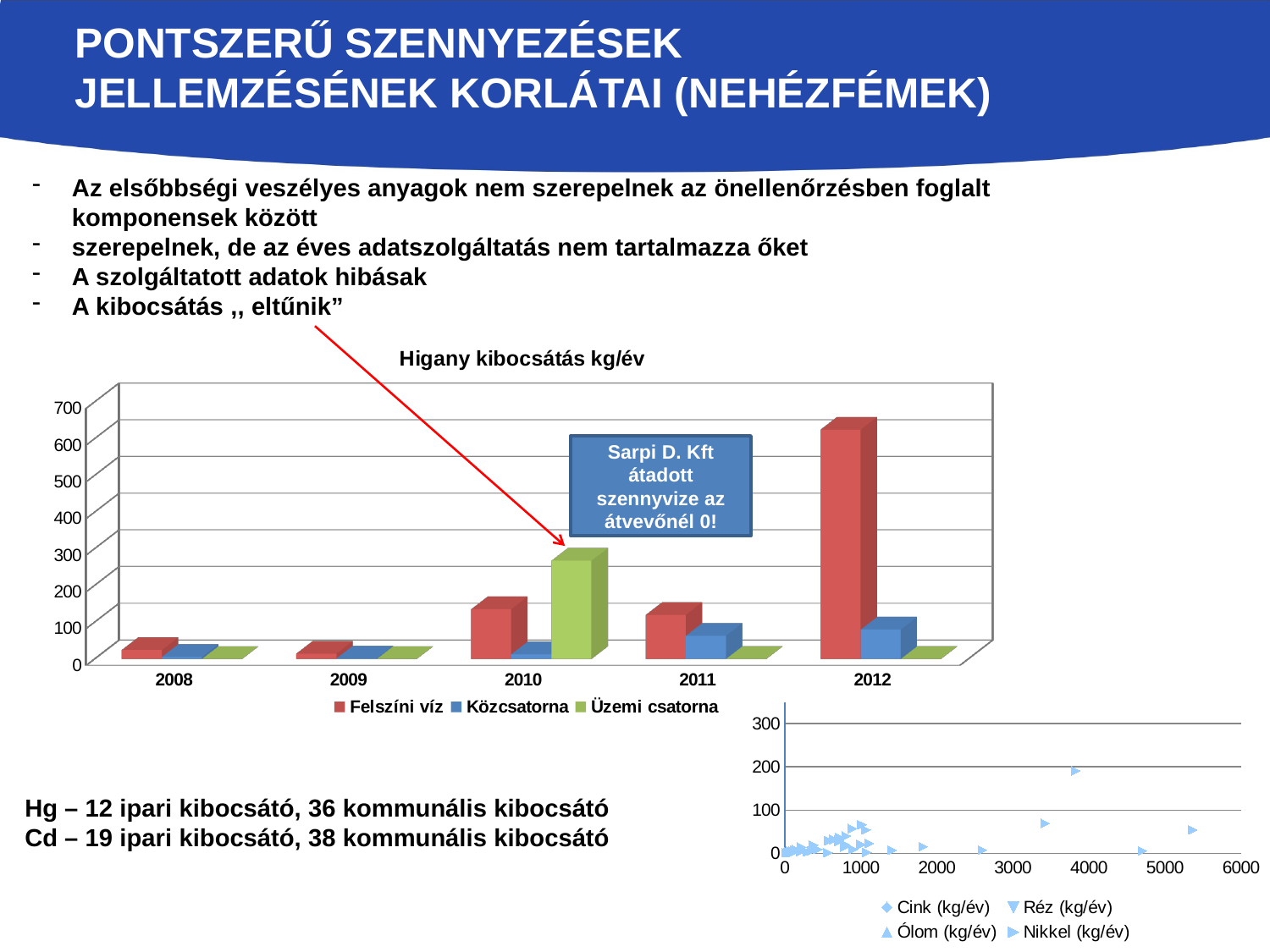
In the 'Higany kibocsátás kg/év' chart, how many years are shown on the x axis? 5 In the 'Higany kibocsátás kg/év' chart, which year has the highest Felszíni víz value? 2012 In the 'Higany kibocsátás kg/év' chart, is the Felszíni víz value for 2012 greater or less than 500? greater In the scatter chart at the bottom right of the slide, how many series does the legend list? 4 In the 'Higany kibocsátás kg/év' chart, which is larger for 2012: Felszíni víz or Közcsatorna? Felszíni víz What is the title of the bar chart on the slide? Higany kibocsátás kg/év In the 'Higany kibocsátás kg/év' chart, is the Felszíni víz value for 2008 greater or less than 100? less In the 'Higany kibocsátás kg/év' chart, how many series does the legend list? 3 In the 'Higany kibocsátás kg/év' chart, which is larger for 2010: Felszíni víz or Üzemi csatorna? Üzemi csatorna In the 'Higany kibocsátás kg/év' chart, is the Üzemi csatorna value for 2010 greater or less than 200? greater What kind of chart is the chart at the bottom right of the slide? scatter chart What kind of chart is the 'Higany kibocsátás kg/év' chart? bar chart